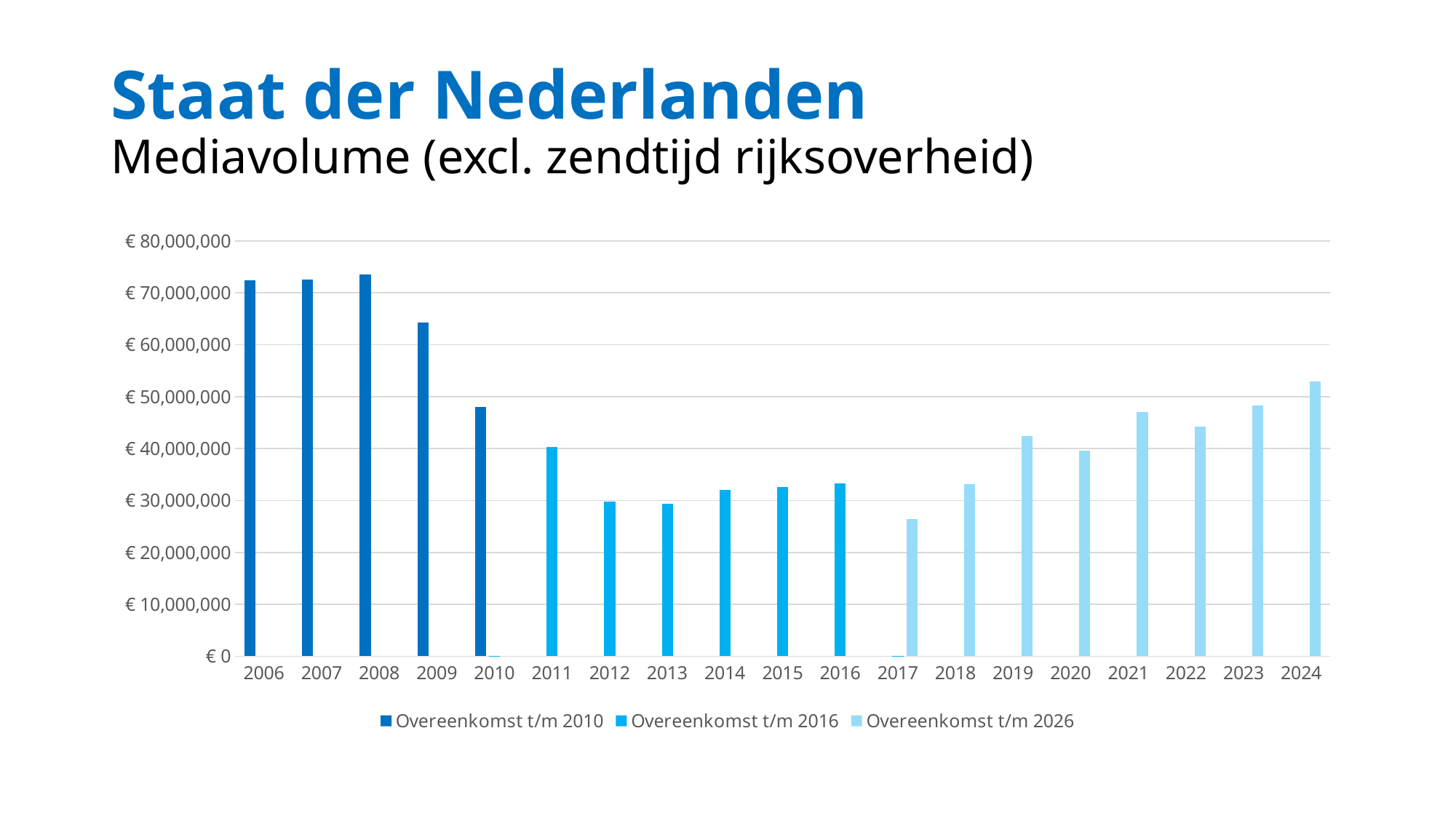
Which legend entry corresponds to the lightest blue bars? Overeenkomst t/m 2026 Which is larger, the value for 2021 or the value for 2024? 2024 How many years are shown on the x axis? 19 What kind of chart is shown on the slide? bar chart Is the value for 2009 greater or less than € 60,000,000? greater How many series does the legend list? 3 Is the value for 2024 greater or less than € 50,000,000? greater Which year has the lowest media volume? 2017 Do the values rise or fall from 2006 to 2010? fall Is the value for 2017 greater or less than € 30,000,000? less Which is larger, the value for 2012 or the value for 2014? 2014